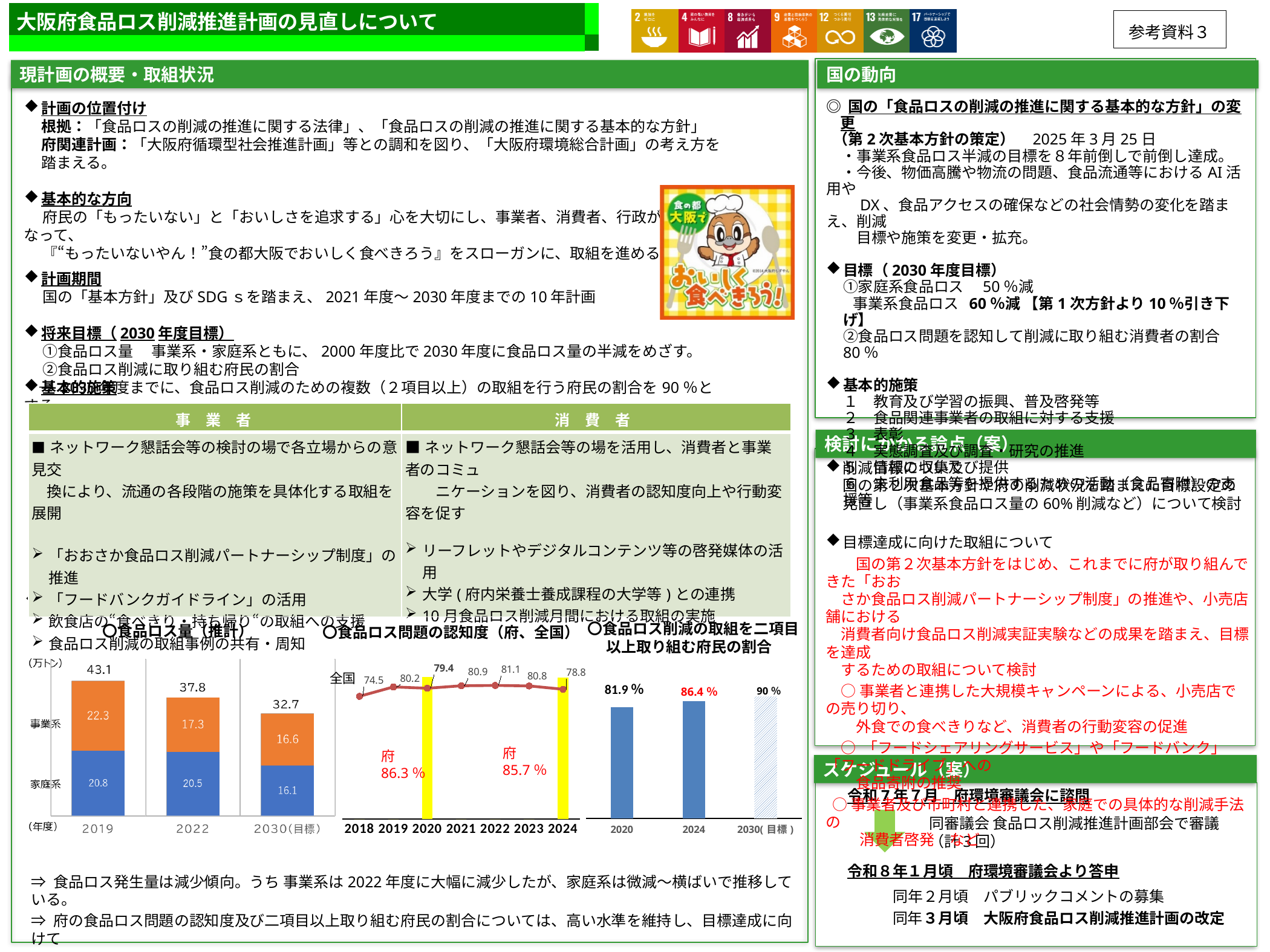
In the 食品ロス問題の認知度（府、全国） chart, what is the 全国 value for 2018? 74.5 In the 食品ロス量（推計） chart, what kind of chart is used? stacked bar chart In the 食品ロス量（推計） chart, what is the total food loss value shown for 2019? 43.1 In the 食品ロス削減の取組を二項目以上取り組む府民の割合 chart, what is the value for 2024? 86.4％ In the 食品ロス量（推計） chart, what is the 事業系 value for 2022? 17.3 In the 食品ロス量（推計） chart, what is the difference between the 事業系 values for 2019 and 2022? 5.0 In the 食品ロス問題の認知度（府、全国） chart, how many years are plotted on the x axis? 7 In the 食品ロス量（推計） chart, what is the 家庭系 value for 2030(目標)? 16.1 In the 食品ロス削減の取組を二項目以上取り組む府民の割合 chart, what is the difference between the 2024 and 2020 values? 4.5％ In the 食品ロス問題の認知度（府、全国） chart, which year has the highest 全国 value? 2022 In the 食品ロス問題の認知度（府、全国） chart, what is the 府 value for 2024? 85.7％ In the 食品ロス量（推計） chart, which year has the lowest total food loss? 2030(目標)